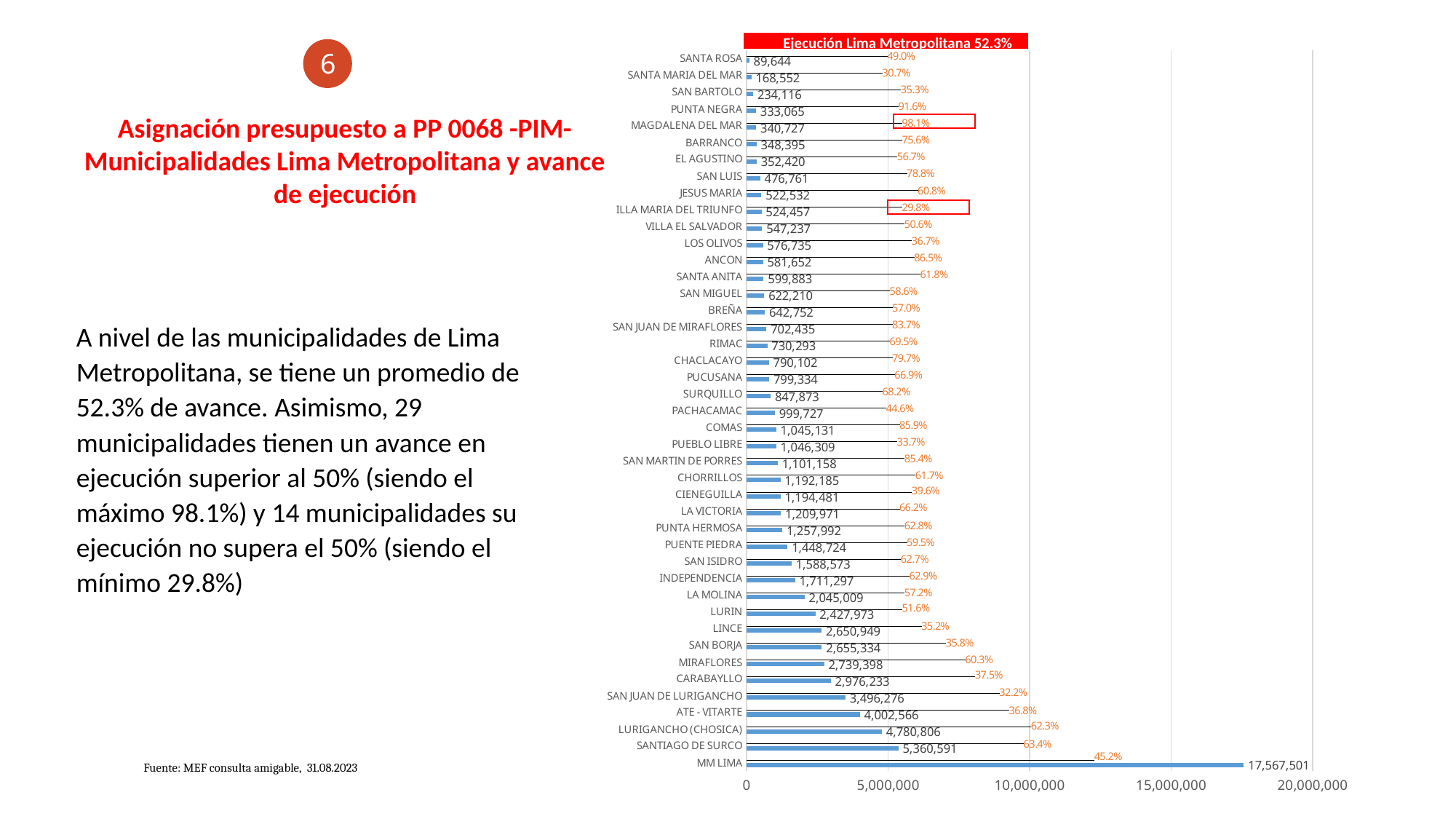
Which municipality has the smallest PIM value? SANTA ROSA How many municipalities are listed on the chart? 43 Which municipality has the largest PIM bar? MM LIMA What type of chart is shown on the slide? Bar chart What is the PIM value shown for MM LIMA? 17,567,501 Which has a larger PIM value, ATE - VITARTE or SAN JUAN DE LURIGANCHO? ATE - VITARTE What is the PIM value shown for SANTIAGO DE SURCO? 5,360,591 What is the title shown in the red box at the top of the chart? Ejecución Lima Metropolitana 52.3% What execution percentage is shown for MAGDALENA DEL MAR? 98.1% What is the difference between the PIM values of SANTIAGO DE SURCO and LURIGANCHO (CHOSICA)? 579,785 Is the PIM value for MM LIMA greater or less than 15,000,000? greater Which municipality has the lowest execution percentage label? ILLA MARIA DEL TRIUNFO